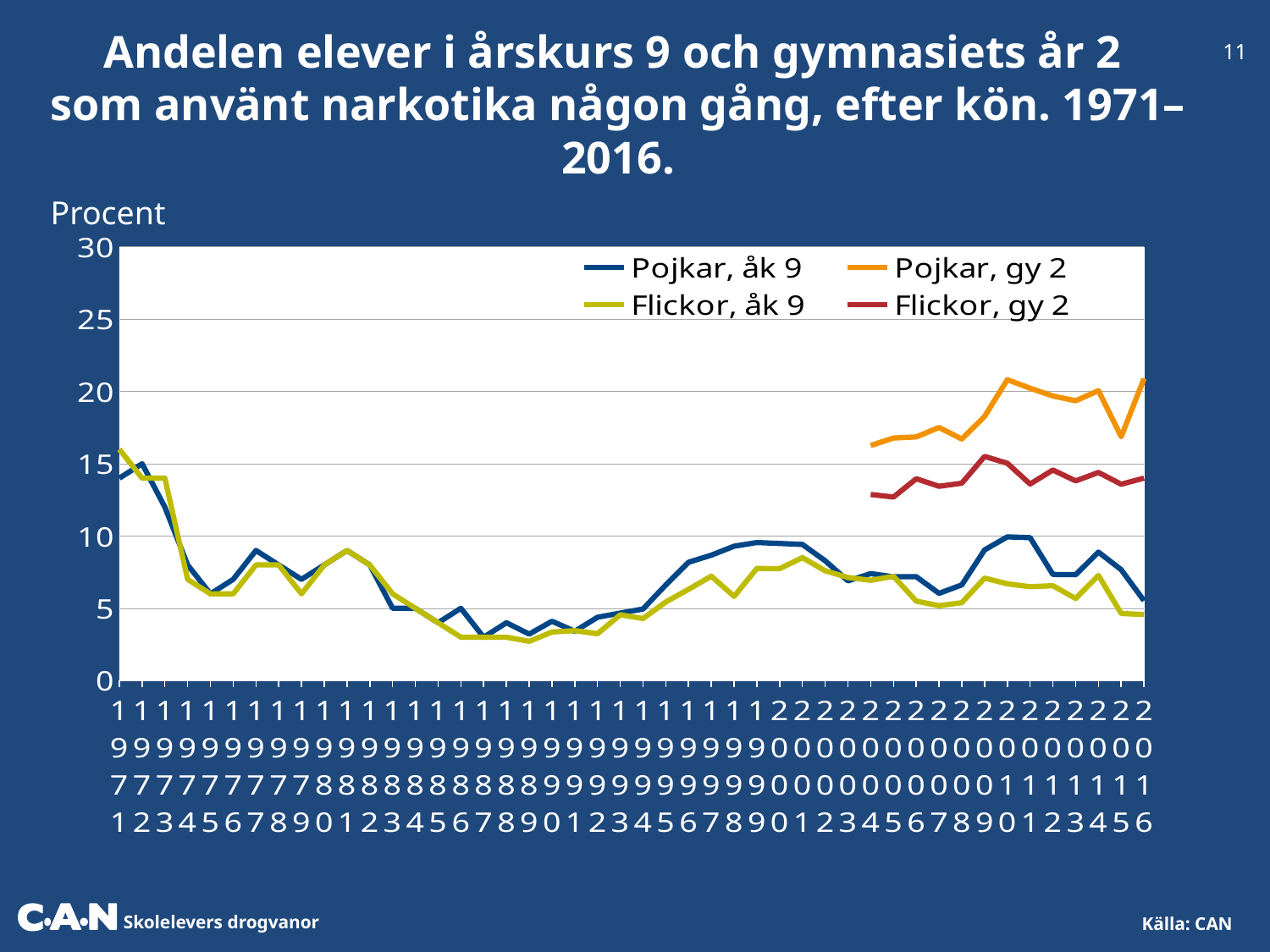
Which series reaches the highest value on the chart? Pojkar, gy 2 Is the value for Pojkar, åk 9 in 2016 greater or less than 10? less In 2016, which is larger: Pojkar, åk 9 or Flickor, åk 9? Pojkar, åk 9 What kind of chart is shown on the slide? Line chart Is the value for Flickor, gy 2 in 2004 greater or less than 15? less Is the value for Pojkar, gy 2 in 2004 greater or less than 15? greater How many series does the legend list? 4 Which series has the lowest value at the last year, 2016? Flickor, åk 9 What are the four series named in the legend? Pojkar, åk 9; Pojkar, gy 2; Flickor, åk 9; Flickor, gy 2 In 2016, which is larger: Pojkar, gy 2 or Flickor, gy 2? Pojkar, gy 2 Does the Pojkar, åk 9 series rise or fall from 1971 to 1975? Fall What label is shown above the vertical axis? Procent